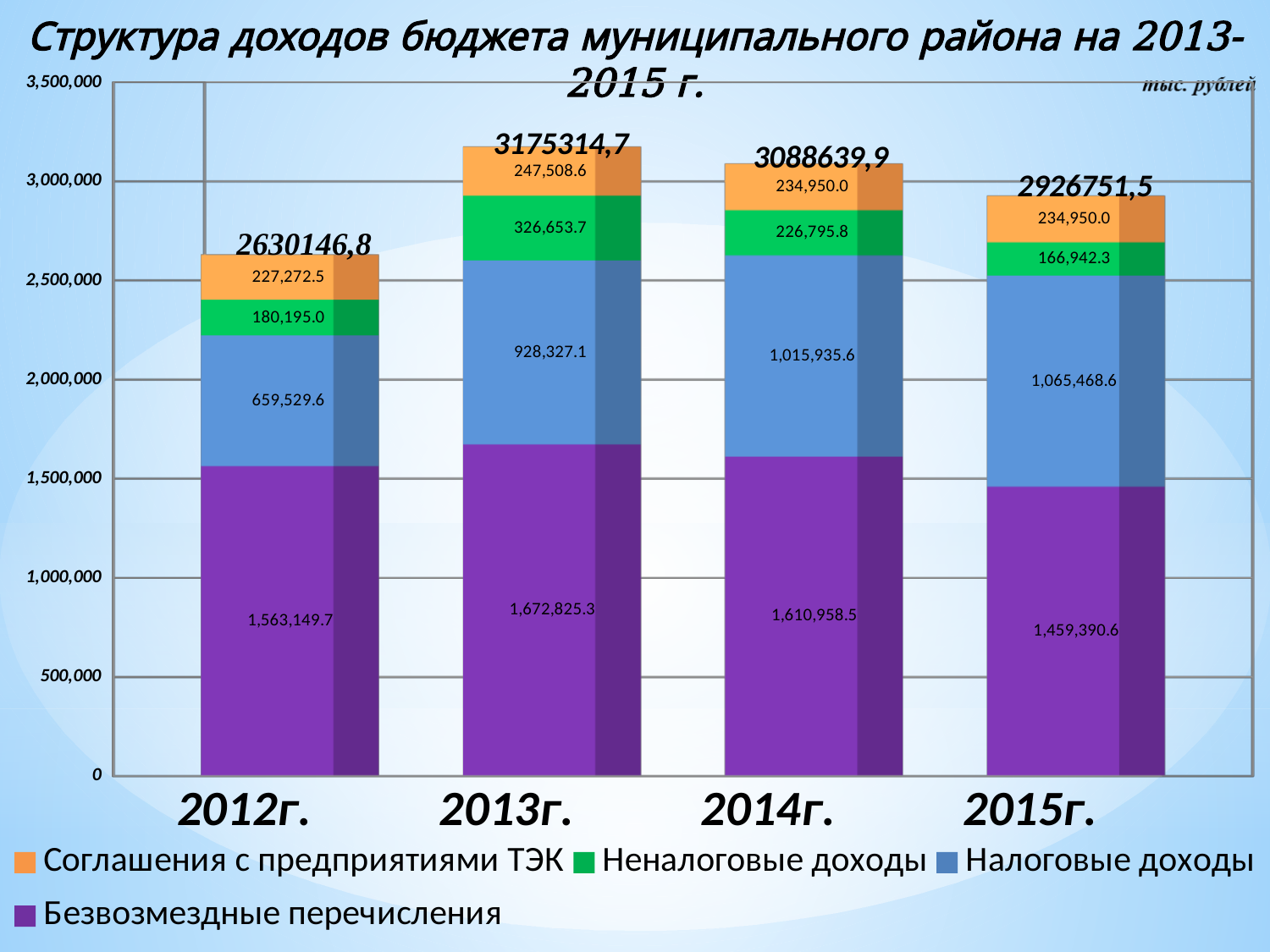
What is the value of Безвозмездные перечисления for 2015г.? 1,459,390.6 How many years are shown on the x axis? 4 Which year has the highest total budget income? 2013г. How many series does the legend list? 4 What is the value of Налоговые доходы for 2014г.? 1,015,935.6 What is the value of Неналоговые доходы for 2013г.? 326,653.7 By how much does Налоговые доходы in 2015г. exceed Налоговые доходы in 2012г.? 405,939.0 What is the total of the stacked bar for 2013г., as printed above it? 3175314,7 What is the value of Соглашения с предприятиями ТЭК for 2012г.? 227,272.5 Which is larger: Неналоговые доходы in 2012г. or in 2015г.? 2012г. Does Безвозмездные перечисления rise or fall from 2013г. to 2015г.? fall Which year has the lowest total budget income? 2012г.